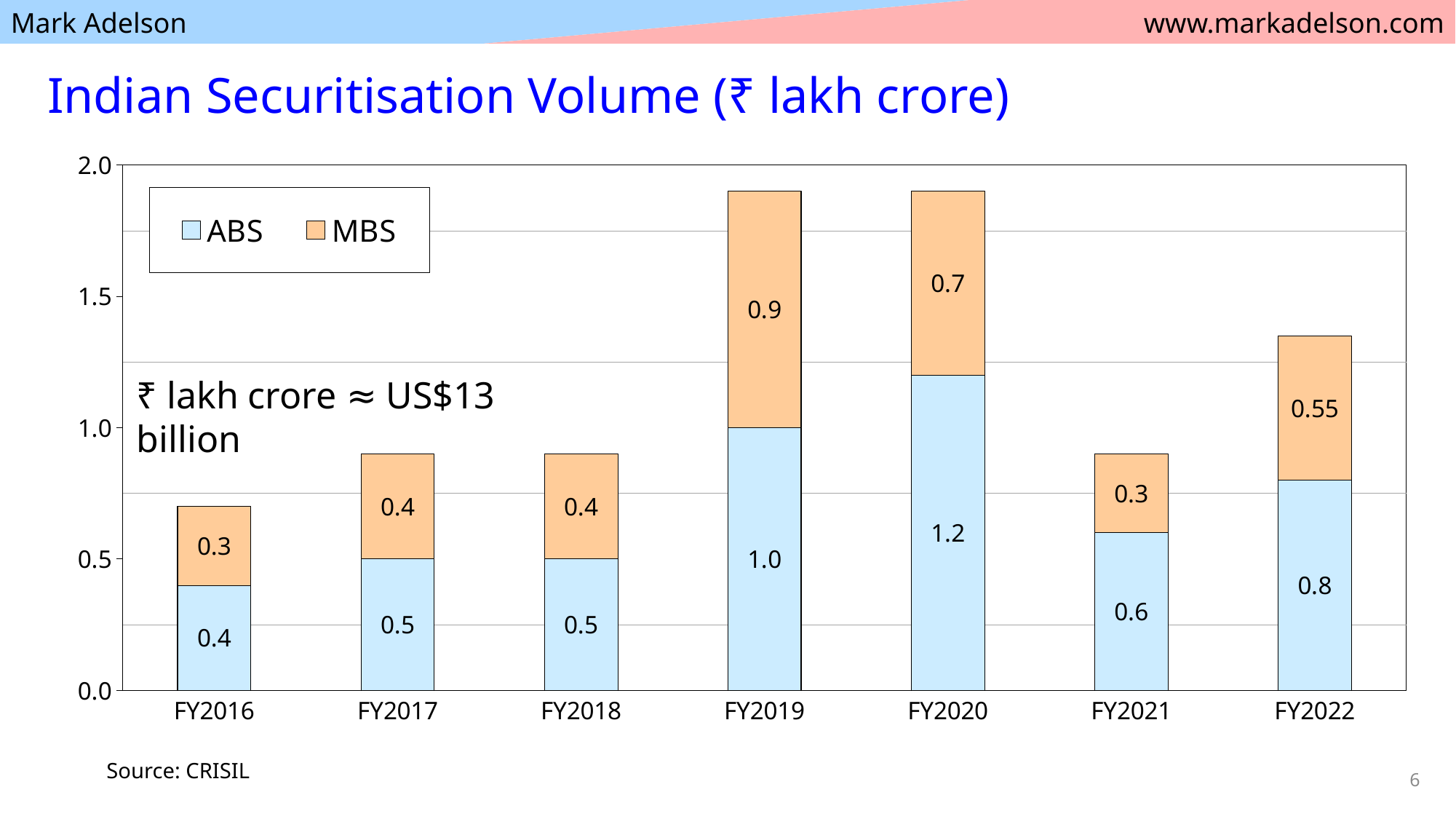
Which is larger, the MBS value for FY2019 or the MBS value for FY2020? FY2019 What is the MBS value for FY2022? 0.55 How many series does the legend list? 2 Which fiscal year has the highest MBS value? FY2019 What is the difference between the ABS values for FY2020 and FY2021? 0.6 What type of chart is shown on the slide? Stacked bar chart Which fiscal year has the lowest ABS value? FY2016 What is the total of the stacked bar for FY2022? 1.35 What is the ABS value for FY2020? 1.2 Which fiscal year has the highest ABS value? FY2020 How many fiscal years are shown on the x axis? 7 Which fiscal year has the lowest total stacked bar? FY2016